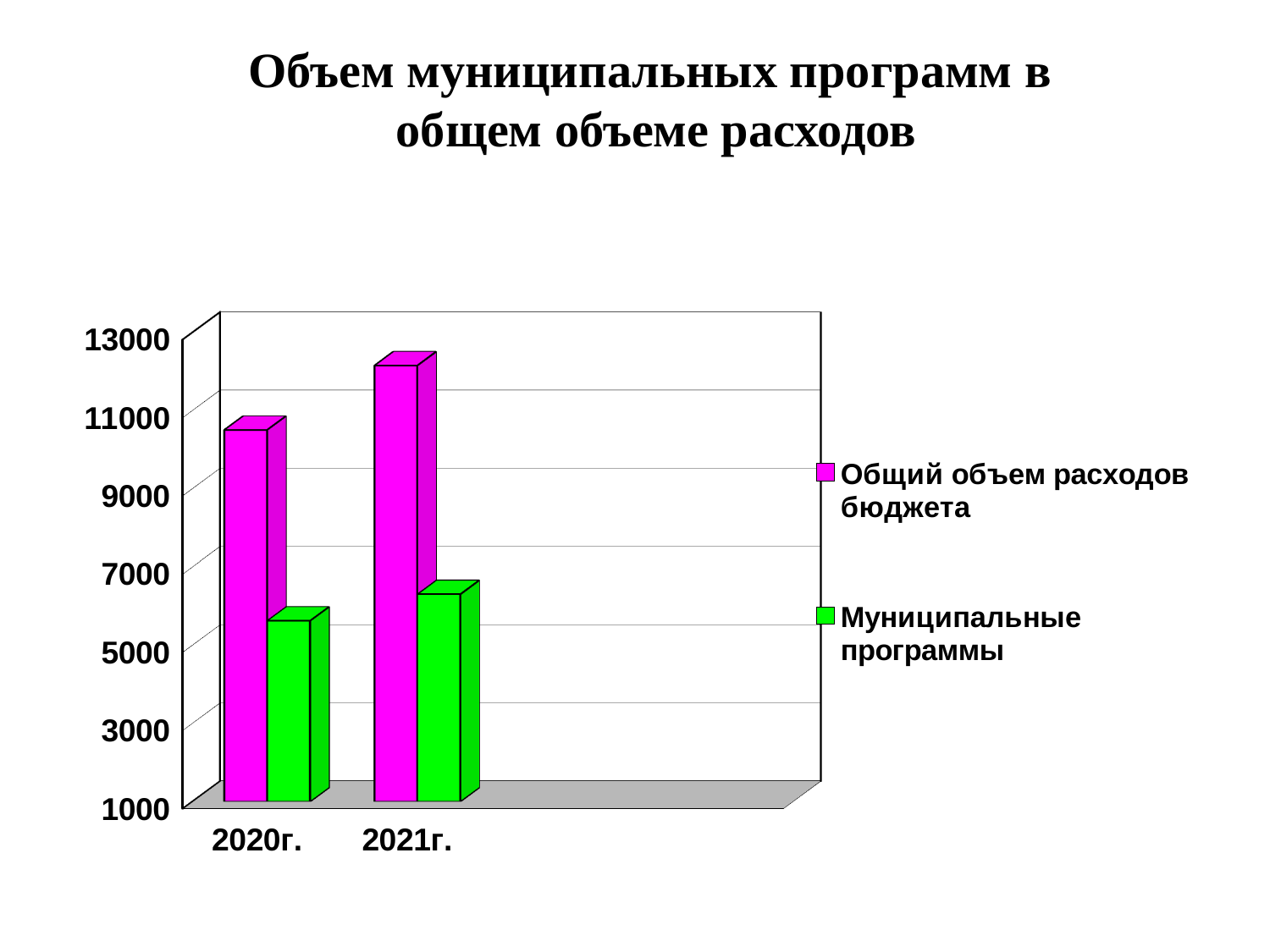
What kind of chart is shown on the slide? bar chart Which year has the highest value for Общий объем расходов бюджета? 2021г. Is the value for Муниципальные программы in 2021г. greater or less than 7000? less Is the value for Общий объем расходов бюджета in 2020г. greater or less than 9000? greater Do the values for Муниципальные программы rise or fall from 2020г. to 2021г.? rise Which is larger in 2021г.: Общий объем расходов бюджета or Муниципальные программы? Общий объем расходов бюджета Is the value for Общий объем расходов бюджета in 2021г. greater or less than 11000? greater How many series does the legend list? 2 How many categories (years) are shown on the x axis? 2 Which year has the lowest value for Муниципальные программы? 2020г. What colour represents the series Муниципальные программы? green